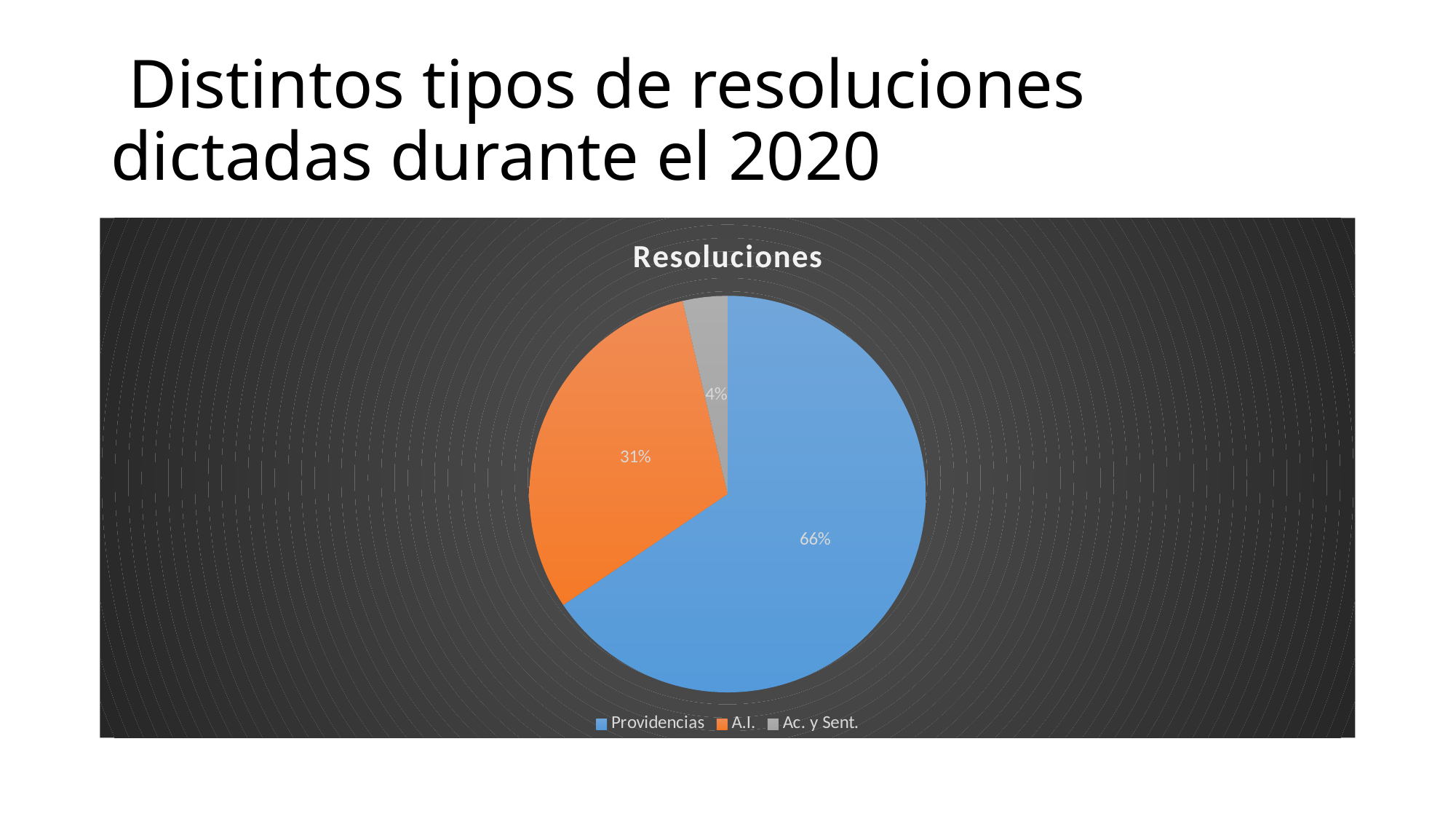
What share of the pie does Providencias represent? 66% What colour is the slice for A.I.? orange What share of the pie does A.I. represent? 31% What share of the pie does Ac. y Sent. represent? 4% Which category has the largest slice of the pie? Providencias What is the difference in percentage points between Providencias and A.I.? 35 Which is larger, the share for A.I. or the share for Ac. y Sent.? A.I. What kind of chart is shown on the slide? pie chart Which category has the smallest slice of the pie? Ac. y Sent. What is the difference in percentage points between A.I. and Ac. y Sent.? 27 What is the title of the chart? Resoluciones How many categories does the legend list? 3